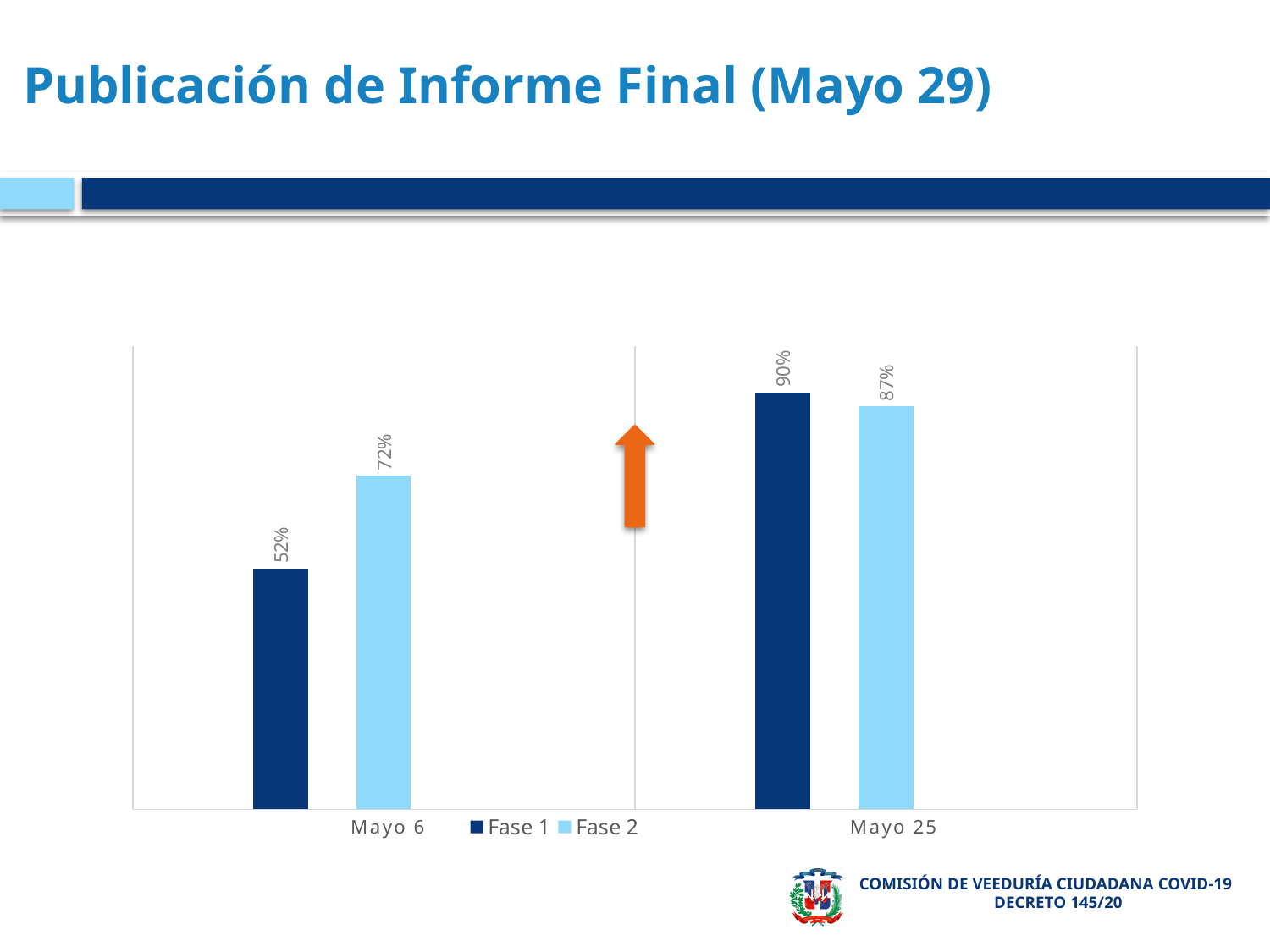
What is the value for Fase 2 on Mayo 6? 72% How many series does the legend list? 2 How many categories are shown on the x axis? 2 Which bar has the highest value in the chart? Fase 1 on Mayo 25 What is the value for Fase 2 on Mayo 25? 87% What is the difference between the Fase 2 and Fase 1 values on Mayo 6? 20% What kind of chart is shown on the slide? Bar chart What is the difference between the Fase 1 values on Mayo 25 and Mayo 6? 38% What is the value for Fase 1 on Mayo 6? 52% Which bar has the lowest value in the chart? Fase 1 on Mayo 6 What is the value for Fase 1 on Mayo 25? 90% Which is larger on Mayo 6, Fase 1 or Fase 2? Fase 2